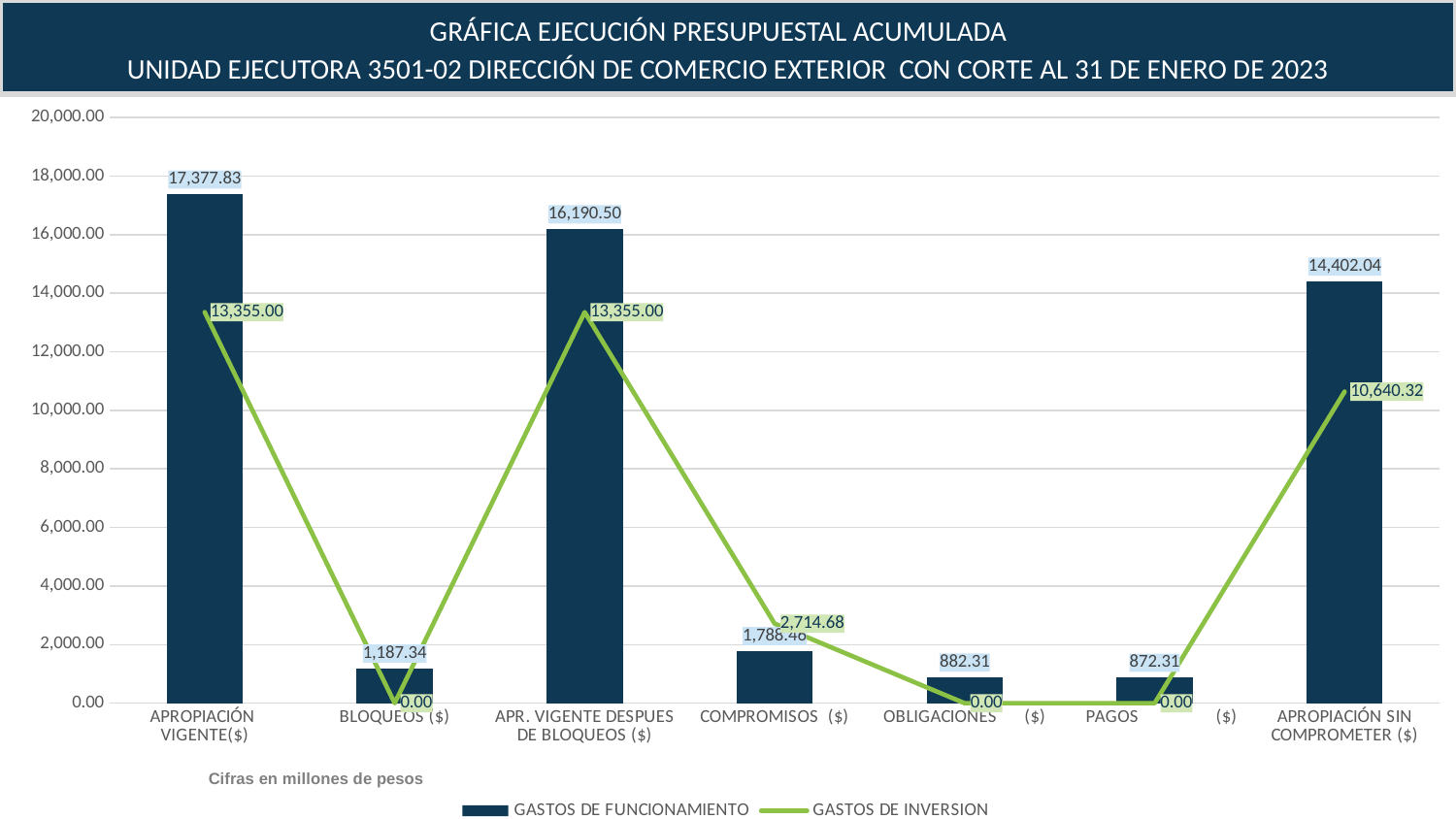
Is the GASTOS DE FUNCIONAMIENTO value for APROPIACIÓN SIN COMPROMETER ($) greater or less than 14,000.00? greater Which is larger for APR. VIGENTE DESPUES DE BLOQUEOS ($): GASTOS DE FUNCIONAMIENTO or GASTOS DE INVERSION? GASTOS DE FUNCIONAMIENTO What is the GASTOS DE FUNCIONAMIENTO value for APROPIACIÓN VIGENTE($)? 17,377.83 What unit are the figures in, according to the note below the chart? Cifras en millones de pesos How many series does the legend list? 2 Which category has the highest GASTOS DE FUNCIONAMIENTO value? APROPIACIÓN VIGENTE($) What is the GASTOS DE INVERSION value for APROPIACIÓN SIN COMPROMETER ($)? 10,640.32 What is the GASTOS DE FUNCIONAMIENTO value for BLOQUEOS ($)? 1,187.34 How many categories are shown on the x axis? 7 What is the GASTOS DE INVERSION value for COMPROMISOS ($)? 2,714.68 Which category has the lowest GASTOS DE FUNCIONAMIENTO value? PAGOS ($) What is the difference between the GASTOS DE FUNCIONAMIENTO values for APROPIACIÓN VIGENTE($) and APR. VIGENTE DESPUES DE BLOQUEOS ($)? 1,187.33